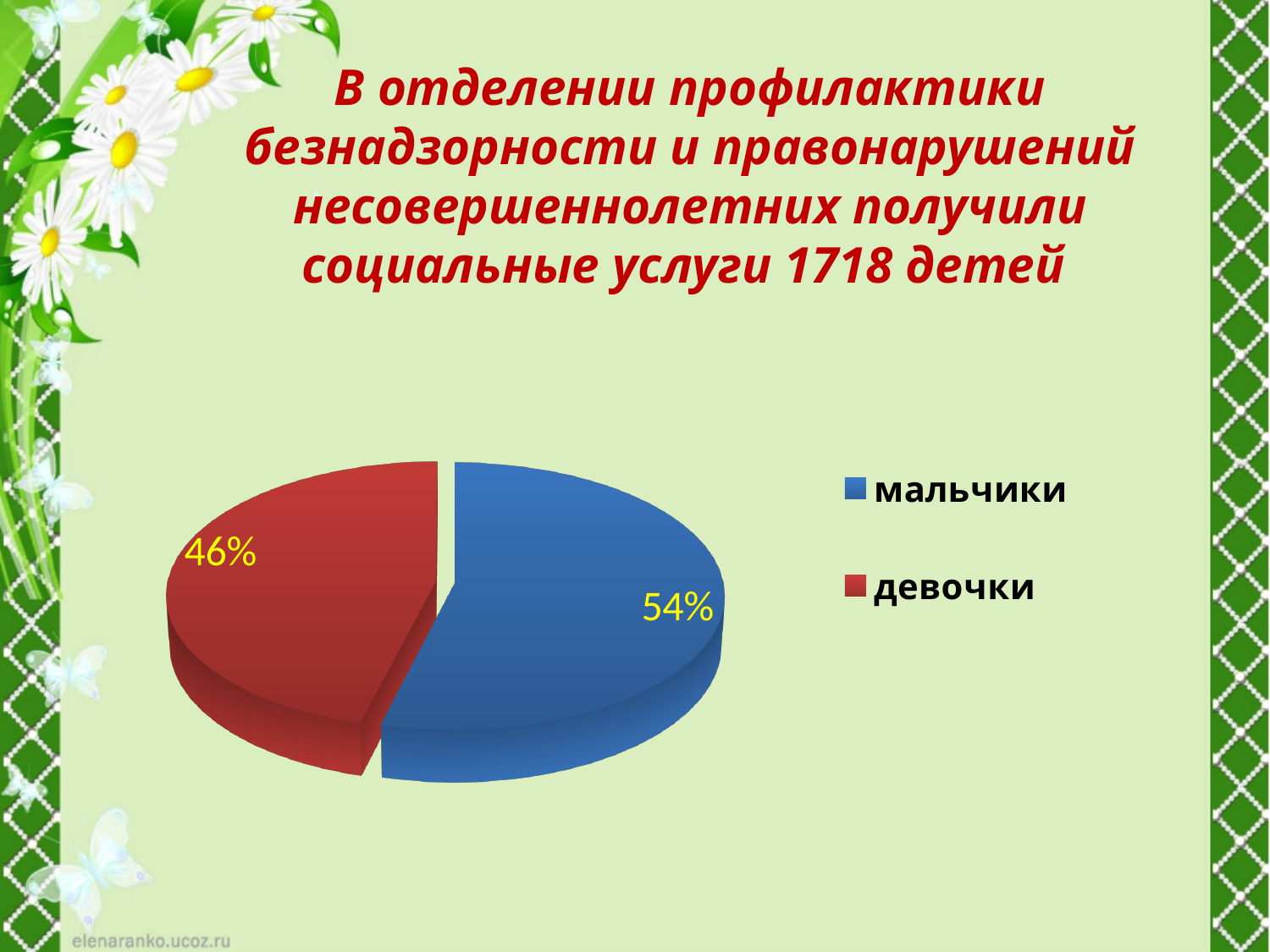
Which category has the smallest share of the pie? девочки What colour is the slice for девочки? red What kind of chart is shown on the slide? pie chart What is the difference in percentage points between мальчики and девочки? 8 How many entries does the legend list? 2 What colour is the slice for мальчики? blue What is the share of the pie for девочки? 46% Which is larger, the share for мальчики or the share for девочки? мальчики What percentage of the pie is labelled for мальчики? 54% How many slices does the pie chart have? 2 What percentage of the pie is labelled for девочки? 46% Which category has the largest share of the pie? мальчики